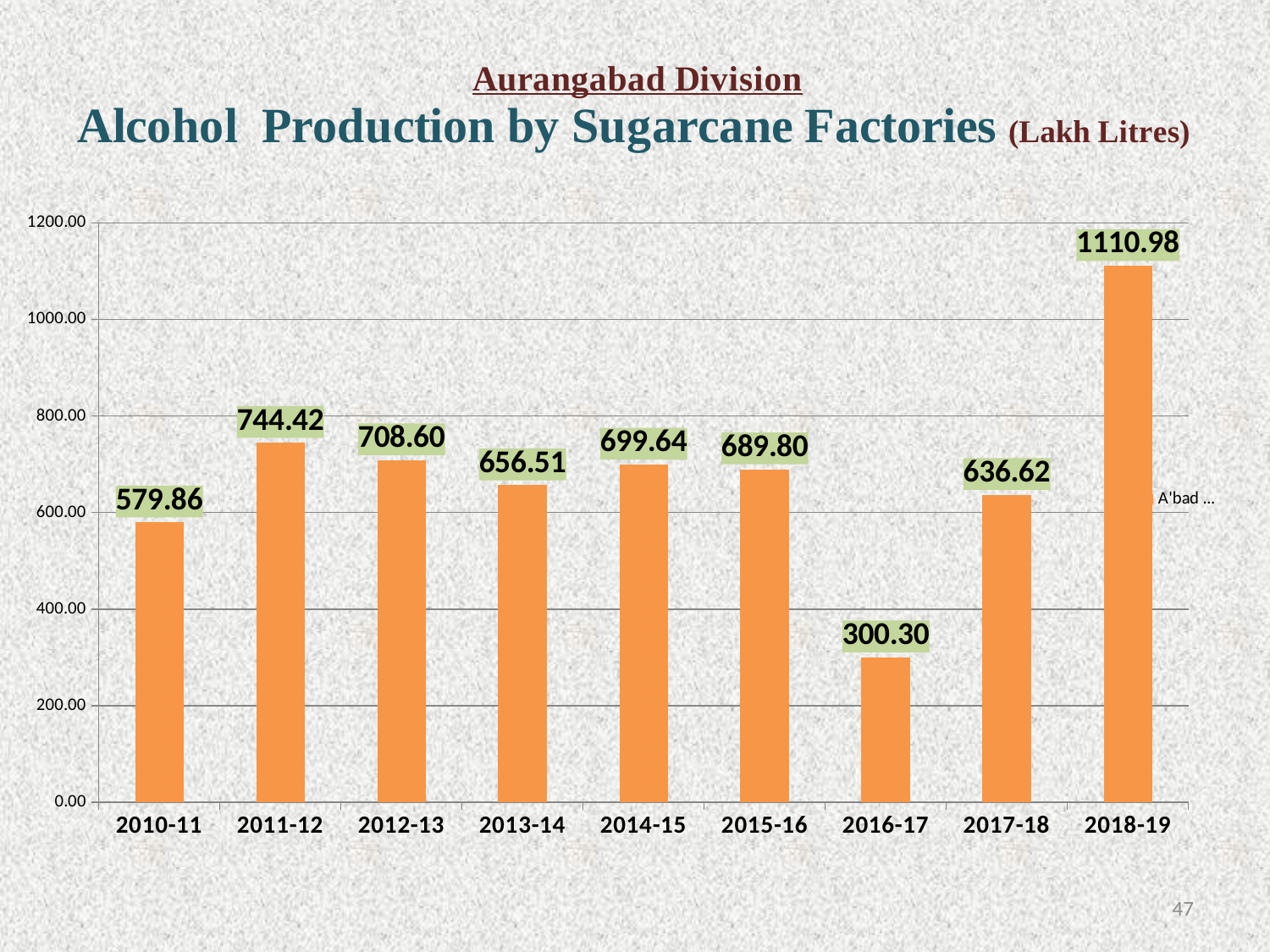
Which year had higher alcohol production, 2012-13 or 2013-14? 2012-13 What was the alcohol production in 2018-19? 1110.98 What is the difference in alcohol production between 2018-19 and 2017-18? 474.36 Which year had the highest alcohol production? 2018-19 How many years are shown on the chart? 9 Which year had the lowest alcohol production? 2016-17 What was the alcohol production in 2016-17? 300.30 What kind of chart is shown on the slide? Bar chart Is the value for 2015-16 greater or less than 600? greater What is the difference in alcohol production between 2011-12 and 2010-11? 164.56 Did alcohol production rise or fall from 2016-17 to 2018-19? Rise What was the alcohol production in 2010-11? 579.86